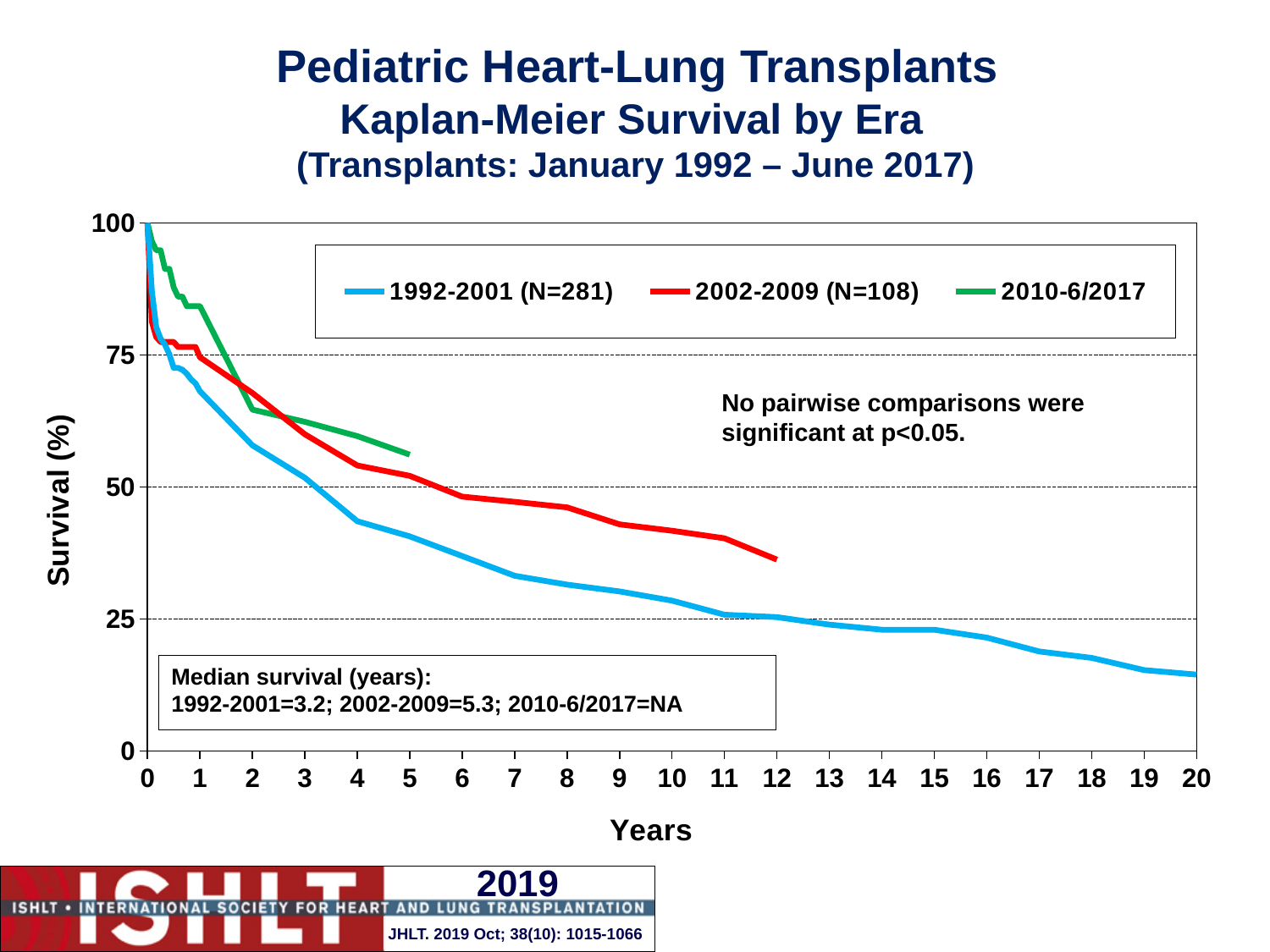
Is the survival value for the 1992-2001 series at 10 years greater or less than 50? less Do the survival curves rise or fall as years increase? fall What is the median survival in years for the 1992-2001 era? 3.2 What is the N for the 1992-2001 series in the legend? 281 Is the survival value for the 2010-6/2017 series at 4 years greater or less than 50? greater What kind of chart is shown on the slide? line chart What is the N for the 2002-2009 series in the legend? 108 What is the median survival given for the 2010-6/2017 era? NA How many series does the legend list? 3 Is the survival value for the 1992-2001 series at 20 years greater or less than 25? less What is the median survival in years for the 2002-2009 era? 5.3 At 10 years, which series has higher survival, 1992-2001 or 2002-2009? 2002-2009